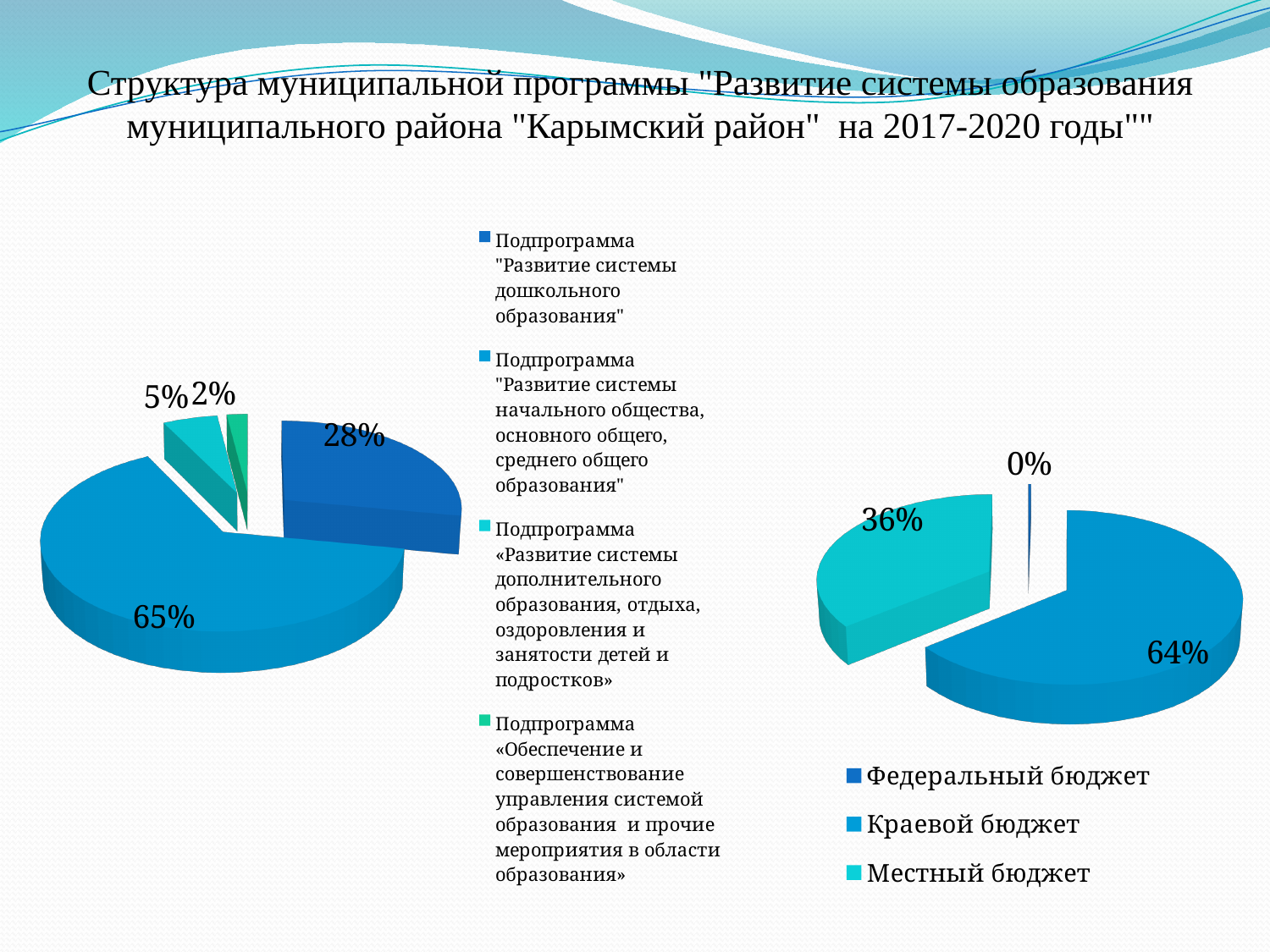
In the right pie chart, what share does Федеральный бюджет have? 0% In the left pie chart, how many slices (subprograms) are shown? 4 How many entries does the legend of the right pie chart list? 3 In the left pie chart, what share does the subprogram "Обеспечение и совершенствование управления системой образования и прочие мероприятия в области образования" have? 2% In the left pie chart, what is the difference between the 65% slice and the 28% slice? 37% In the left pie chart, which subprogram has the largest share? Подпрограмма "Развитие системы начального общества, основного общего, среднего общего образования" What kind of chart is the left chart on the slide? pie chart In the right pie chart, what share does Местный бюджет have? 36% In the right pie chart, which budget source has the smallest share? Федеральный бюджет